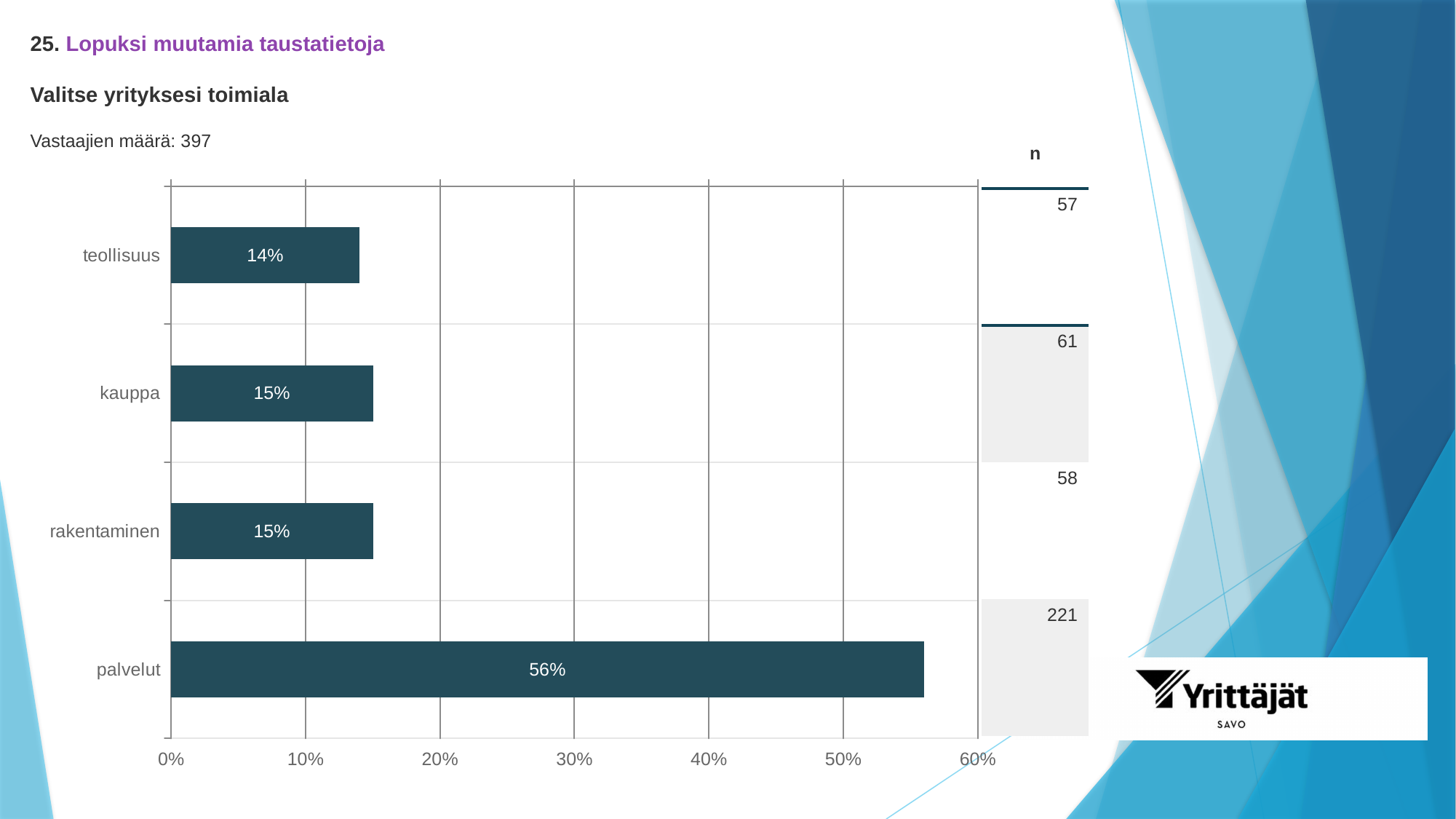
Is the value for palvelut greater or less than 50%? greater Which category has the lowest percentage? teollisuus What is the difference in percentage points between palvelut and kauppa? 41 What percentage is shown for teollisuus? 14% What is the total number of respondents (Vastaajien määrä) stated on the slide? 397 What is the n value for kauppa? 61 What kind of chart is shown on the slide? bar chart Which category has the highest percentage? palvelut Which has a larger n value, teollisuus or rakentaminen? rakentaminen What percentage is shown for palvelut? 56% How many categories are shown in the chart? 4 What is the n value for palvelut? 221